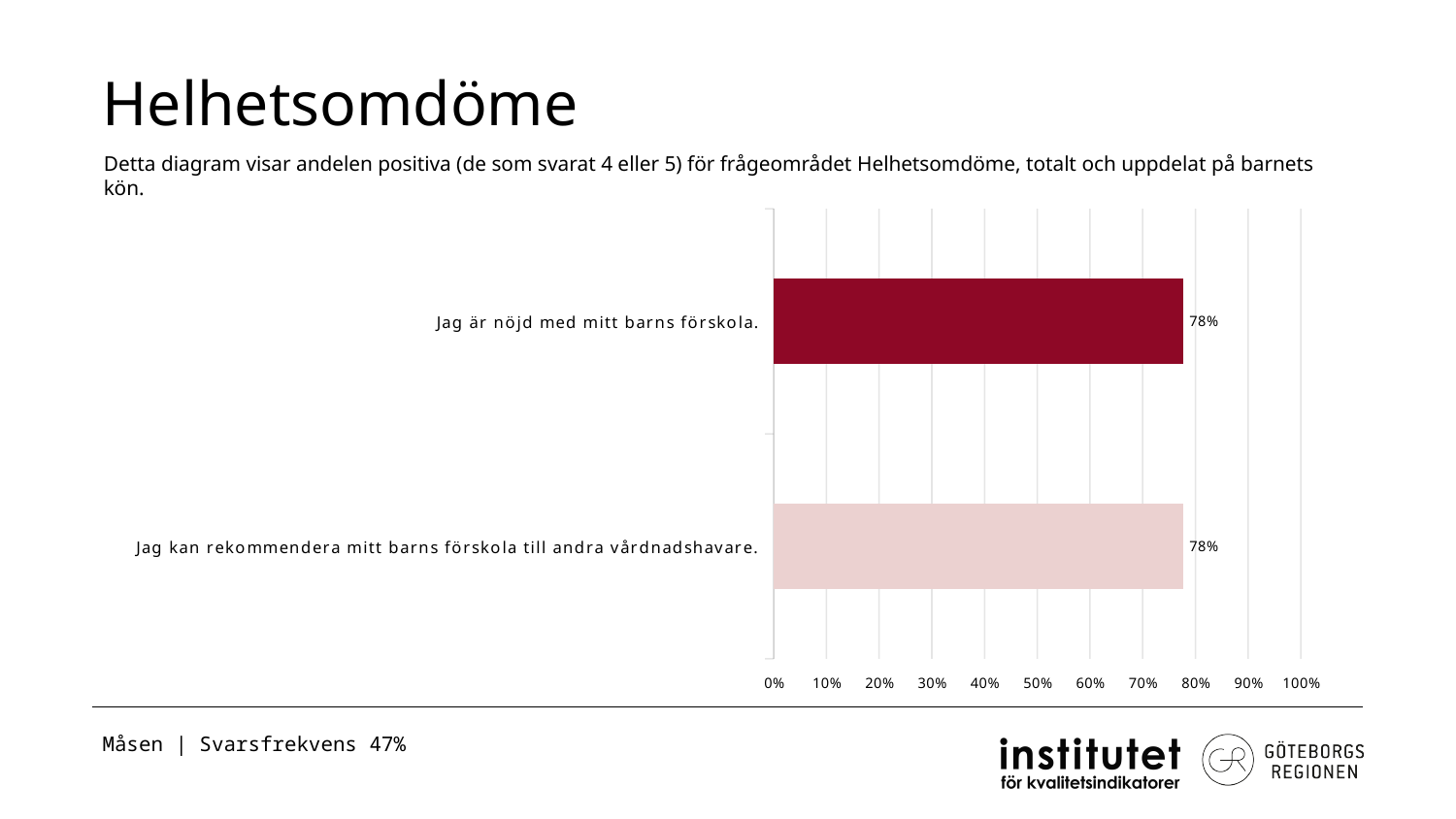
What is the title of the slide containing the chart? Helhetsomdöme What is the difference between the value for "Jag är nöjd med mitt barns förskola." and the value for "Jag kan rekommendera mitt barns förskola till andra vårdnadshavare."? 0 percentage points What is the value for "Jag är nöjd med mitt barns förskola."? 78% What is the value for "Jag kan rekommendera mitt barns förskola till andra vårdnadshavare."? 78% Is the value for "Jag är nöjd med mitt barns förskola." greater or less than 70%? greater How many categories are plotted in the chart? 2 What is the highest value shown on the x axis of the chart? 100% Is the value for "Jag kan rekommendera mitt barns förskola till andra vårdnadshavare." greater or less than 80%? less Do the two categories have the same value? Yes, both are 78% What kind of chart is shown on the slide? Bar chart